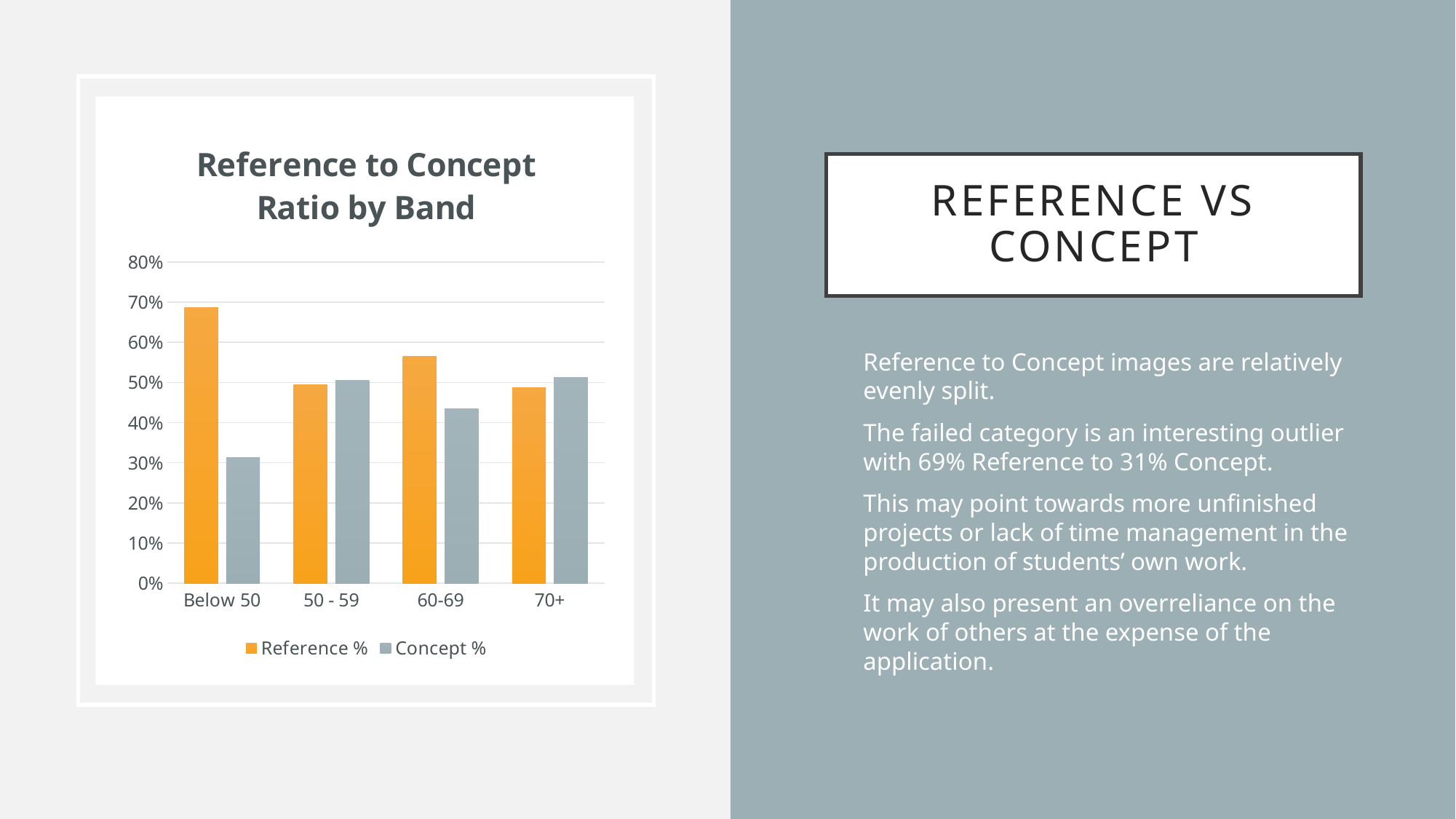
Which band has the lowest Concept % value? Below 50 Is the Reference % value for Below 50 greater or less than 60%? greater Is the Concept % value for 60-69 greater or less than 50%? less How many bands (categories) are shown on the x axis? 4 For the Below 50 band, which is larger: Reference % or Concept %? Reference % What type of chart is shown on the slide? bar chart How many series does the chart legend list? 2 Which colour represents the Concept % series in the chart? grey What is the title of the chart? Reference to Concept Ratio by Band Is the Concept % value for Below 50 greater or less than 40%? less For the 60-69 band, which is larger: Reference % or Concept %? Reference % Which band has the highest Reference % value? Below 50